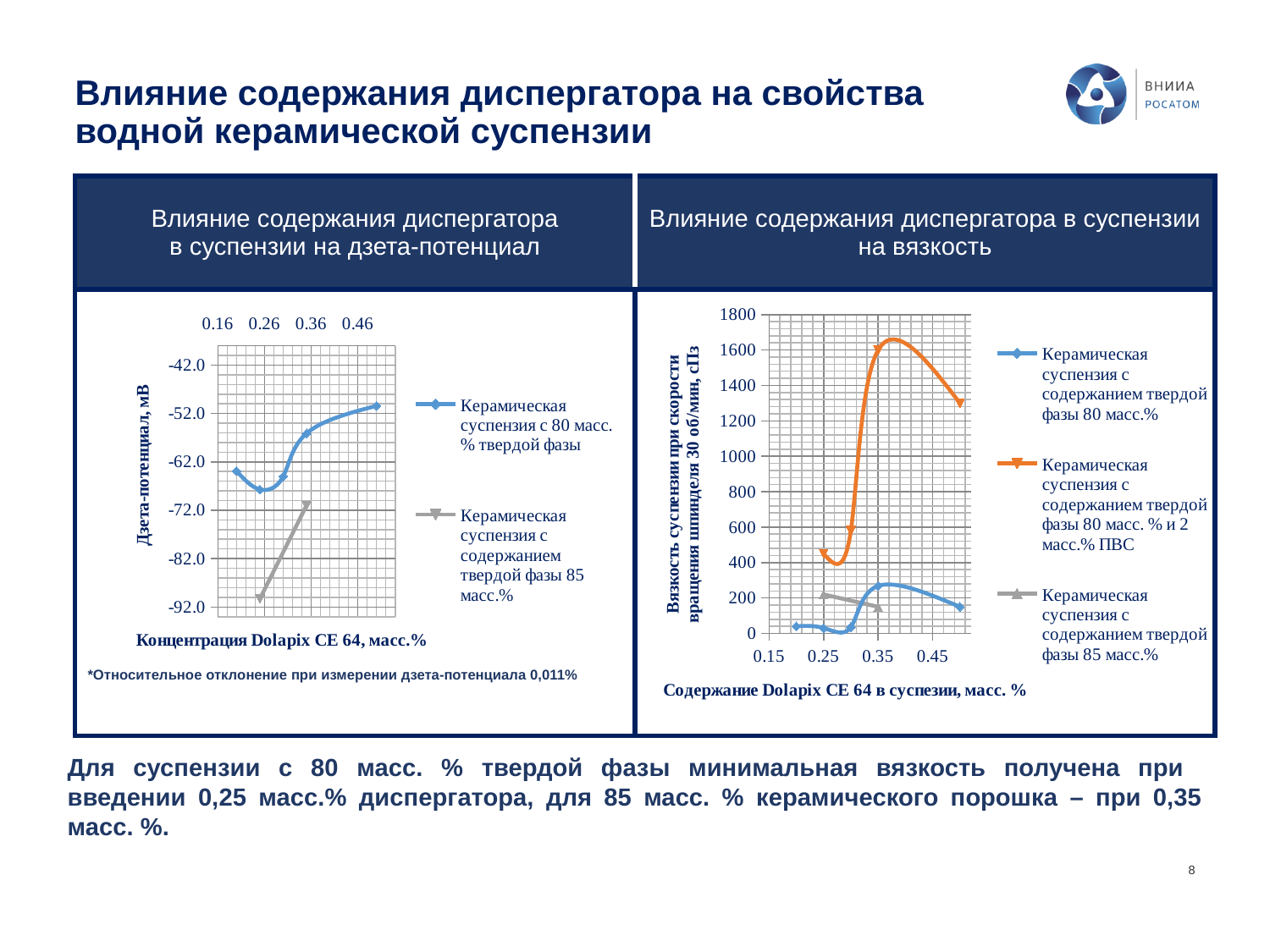
In the right chart (viscosity), is the peak value of the series with 80 mass.% solid phase and 2 mass.% PVA greater or less than 1400? greater In the left chart (zeta potential), is the value of the 85 mass.% series at 0.26 greater or less than -82.0? less In the right chart (viscosity), is the value of the series with 80 mass.% solid phase (without PVA) at 0.35 greater or less than 200? greater How many series does the legend of the right chart (viscosity) list? 3 What is the x-axis label of the right chart? Содержание Dolapix CE 64 в суспезии, масс. % In the left chart (zeta potential), does the 80 mass.% series rise or fall between 0.26 and 0.46? rise How many series does the legend of the left chart (zeta potential) list? 2 In the right chart (viscosity), which series reaches the highest viscosity? Керамическая суспензия с содержанием твердой фазы 80 масс. % и 2 масс.% ПВС In the left chart (zeta potential), how many data points does the 85 mass.% series have? 2 What kind of chart is the left chart on zeta potential? line chart What is the y-axis label of the left chart? Дзета-потенциал, мВ